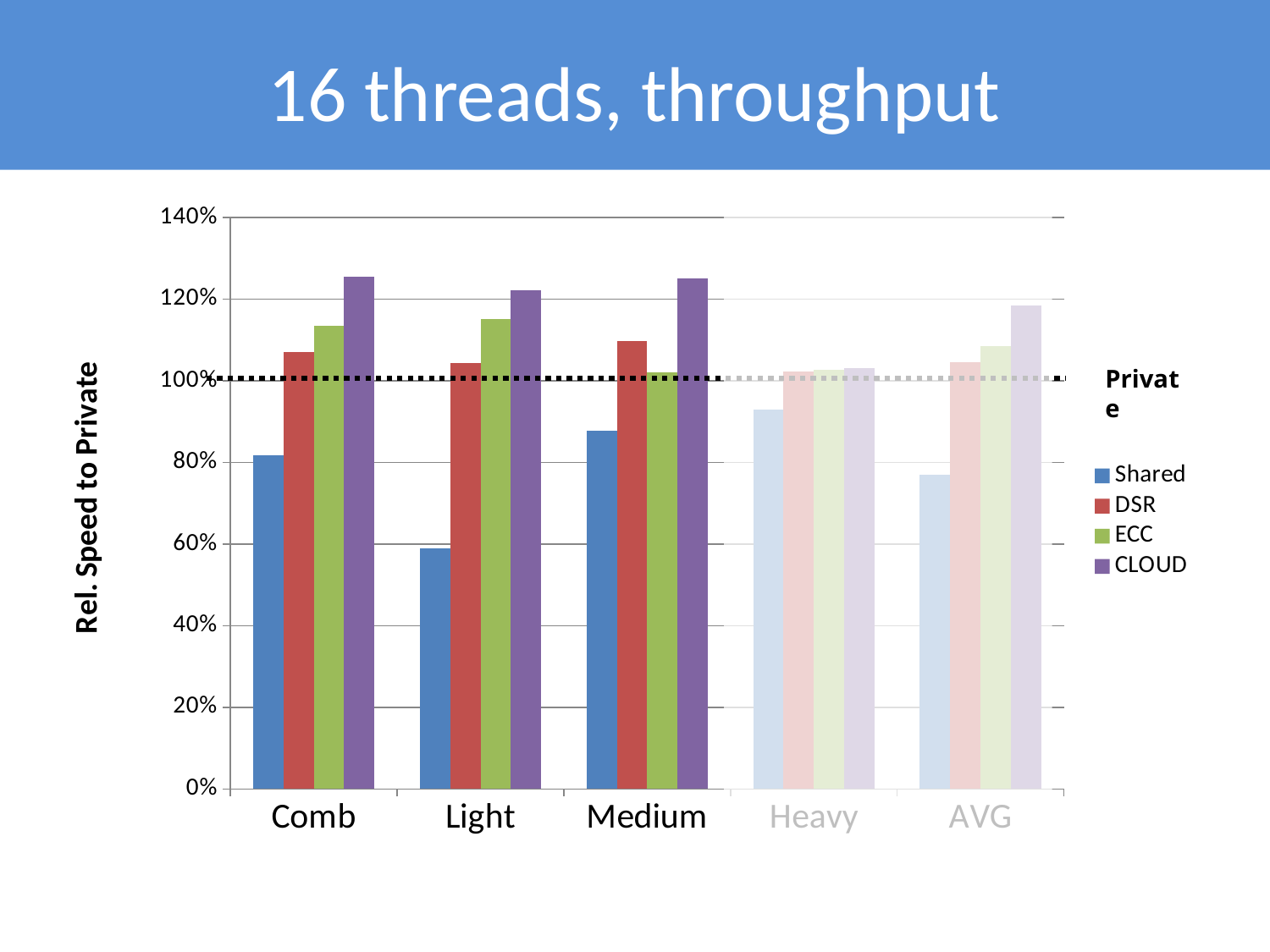
How many categories are shown along the x axis? 5 Is the value for CLOUD in the Comb category greater or less than 120%? greater Is the value for Shared in the Light category greater or less than 80%? less What is the title of the y axis? Rel. Speed to Private In the Medium category, which is larger, DSR or ECC? DSR Is the value for Shared in the Medium category greater or less than 100%? less Which series has the highest bar in the Light category? CLOUD How many bar series does the legend list (excluding the Private line)? 4 At what level does the dotted Private reference line sit? 100% What kind of chart is shown on the slide? bar chart Which is larger, the Shared value for Light or the Shared value for Medium? Medium Which series has the lowest bar in the Comb category? Shared